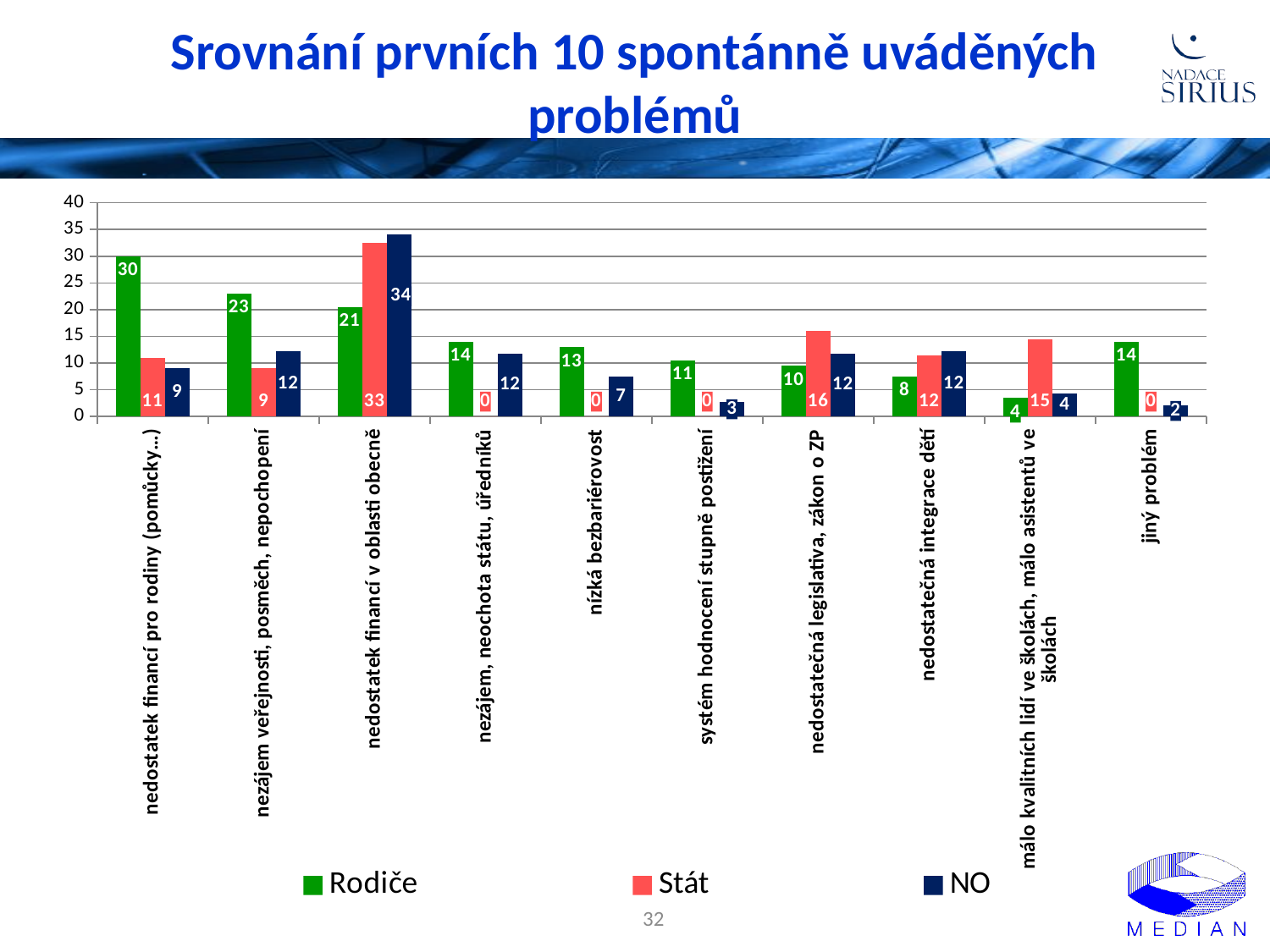
Which colour represents the Stát series in the legend? red Is the Rodiče value for 'nezájem veřejnosti, posměch, nepochopení' greater or less than 20? greater What is the difference between the Rodiče and Stát values for 'nedostatek financí pro rodiny (pomůcky...)'? 19 Which category has the highest value for the Stát series? nedostatek financí v oblasti obecně How many categories are shown on the x axis? 10 What is the value for NO for 'nedostatek financí v oblasti obecně'? 34 What kind of chart is shown on the slide? bar chart What is the value for Stát for 'nedostatečná legislativa, zákon o ZP'? 16 How many series does the legend list? 3 Which category has the lowest value for the NO series? jiný problém What is the value for Rodiče for 'nedostatek financí pro rodiny (pomůcky...)'? 30 Which is larger for 'málo kvalitních lidí ve školách, málo asistentů ve školách': the Stát value or the Rodiče value? Stát